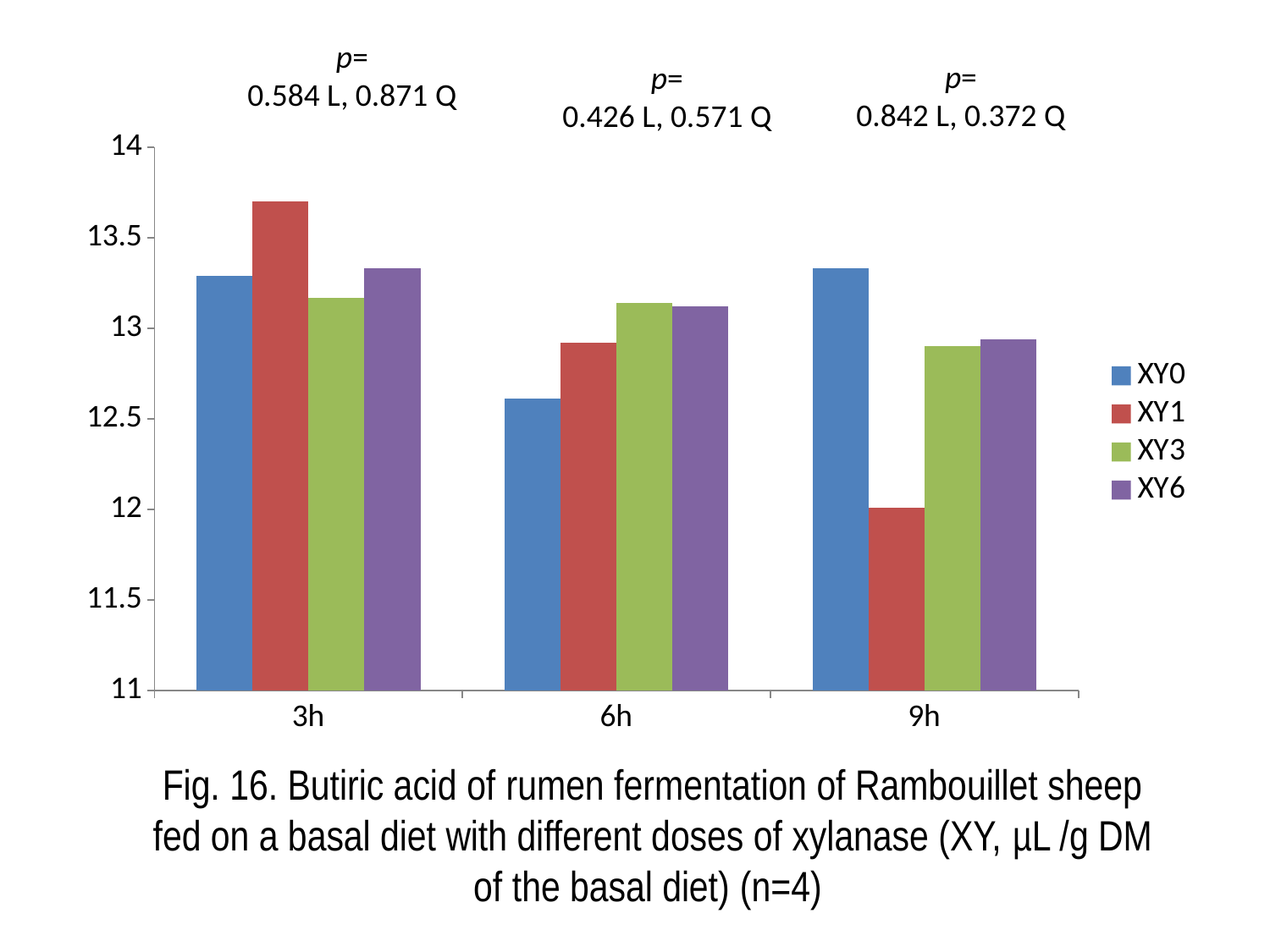
At 6h, which series has the lowest value? XY0 At 3h, which series has the highest butyric acid value? XY1 Which is larger: the XY1 value at 3h or the XY1 value at 9h? 3h Is the value for XY0 at 6h greater or less than 13? less At 9h, which series has the lowest value? XY1 What kind of chart is shown on the slide? bar chart What p-values are printed above the 3h group? p= 0.584 L, 0.871 Q How many series does the legend list? 4 Is the value for XY1 at 3h greater or less than 13.5? greater Which is larger: the XY0 value at 6h or the XY0 value at 9h? 9h Is the value for XY1 at 9h greater or less than 12.5? less How many time-point categories are shown on the x axis? 3